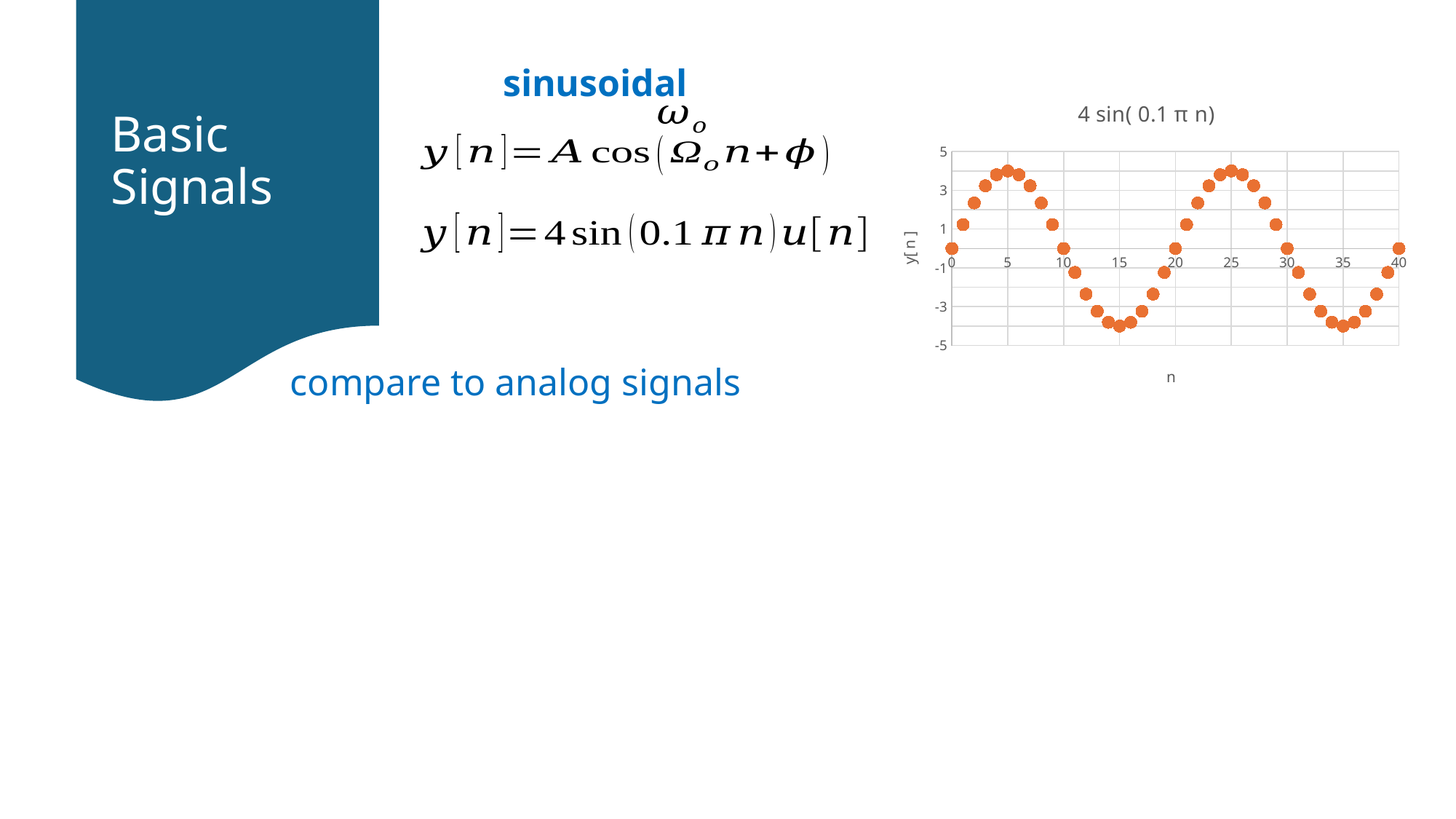
Is the value for n = 25 greater or less than 3? greater Is the value for n = 2 greater or less than 1? greater Which has the larger value, n = 35 or n = 25? n = 25 Do the values rise or fall as n goes from 5 to 15? fall Is the value for n = 15 greater or less than -3? less Which has the larger value, n = 5 or n = 15? n = 5 What is the title of the chart? 4 sin( 0.1 π n) What kind of chart is shown on the slide? scatter chart What label is shown on the vertical axis of the chart? y[ n ]